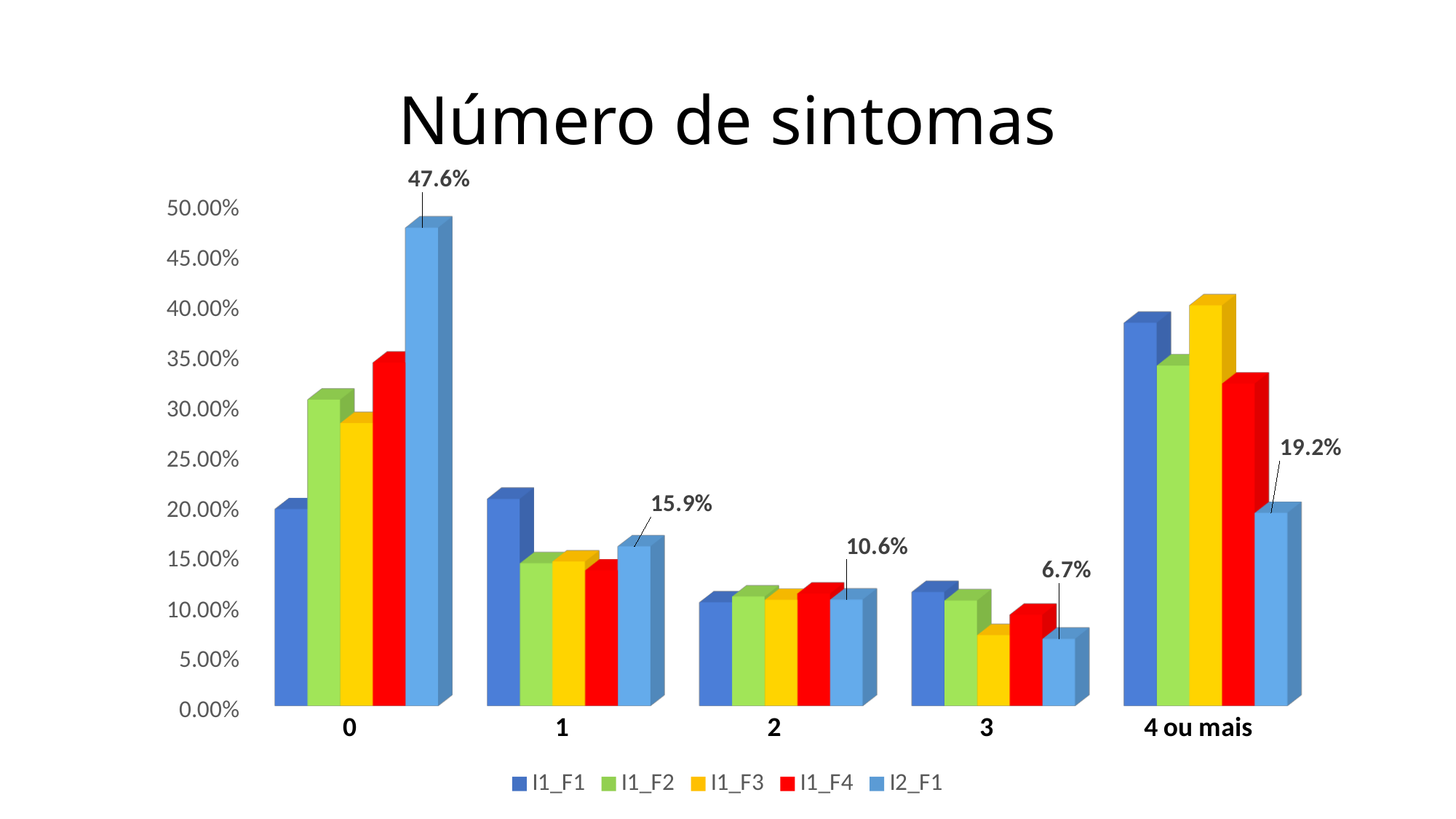
What is the value of I2_F1 for category "4 ou mais"? 19.2% How many series does the legend list? 5 Is the value of I1_F3 for category "4 ou mais" greater or less than 35.00%? greater Which is larger for I2_F1: the value for category 1 or for category "4 ou mais"? 4 ou mais What is the value of I2_F1 for category 3? 6.7% How many categories are shown on the x axis? 5 What is the title of the chart? Número de sintomas What is the difference between the I2_F1 values for category 0 and category "4 ou mais"? 28.4% For the I2_F1 series, which category has the lowest value? 3 For the I2_F1 series, which category has the highest value? 0 Is the value of I1_F1 for category 0 greater or less than 25.00%? less What is the value of I2_F1 for category 0? 47.6%